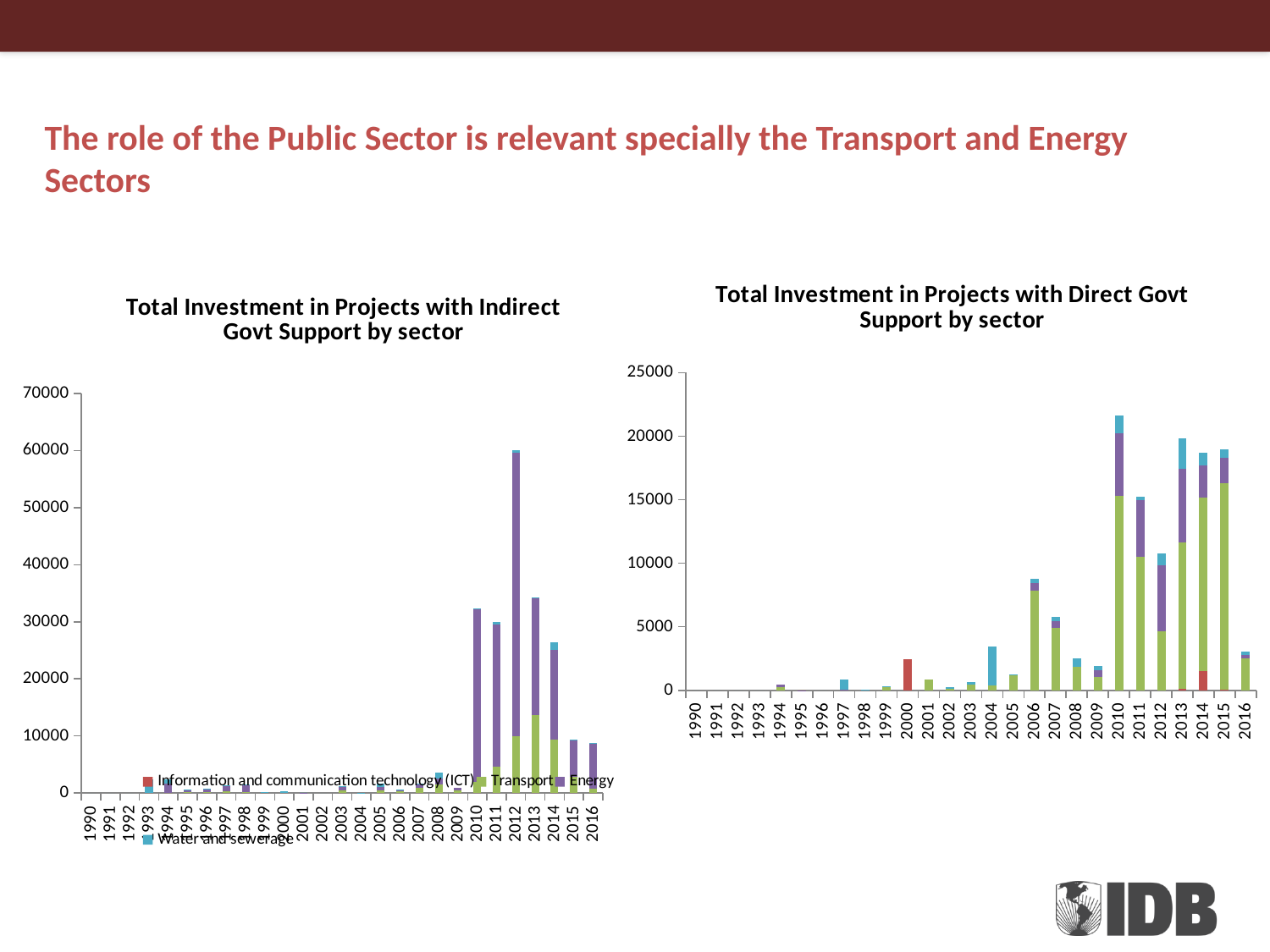
In the 'Total Investment in Projects with Direct Govt Support by sector' chart, how many years are shown on the x axis? 27 In the 'Total Investment in Projects with Direct Govt Support by sector' chart, is the total for 2010 greater or less than 20000? greater Which series are listed in the legend of the 'Total Investment in Projects with Indirect Govt Support by sector' chart? Information and communication technology (ICT), Transport, Energy, Water and sewerage In the 'Total Investment in Projects with Direct Govt Support by sector' chart, is the total for 2006 greater or less than 10000? less In the 'Total Investment in Projects with Indirect Govt Support by sector' chart, is the total for 2014 greater or less than 30000? less In the 'Total Investment in Projects with Indirect Govt Support by sector' chart, which year has the highest total investment? 2012 In the 'Total Investment in Projects with Indirect Govt Support by sector' chart, which year has the larger total, 2010 or 2014? 2010 How many series does the legend of the 'Total Investment in Projects with Indirect Govt Support by sector' chart list? 4 What kind of chart is the 'Total Investment in Projects with Indirect Govt Support by sector' chart? Stacked bar chart In the 'Total Investment in Projects with Direct Govt Support by sector' chart, which year has the larger total, 2010 or 2012? 2010 In the 'Total Investment in Projects with Direct Govt Support by sector' chart, which year has the highest total investment? 2010